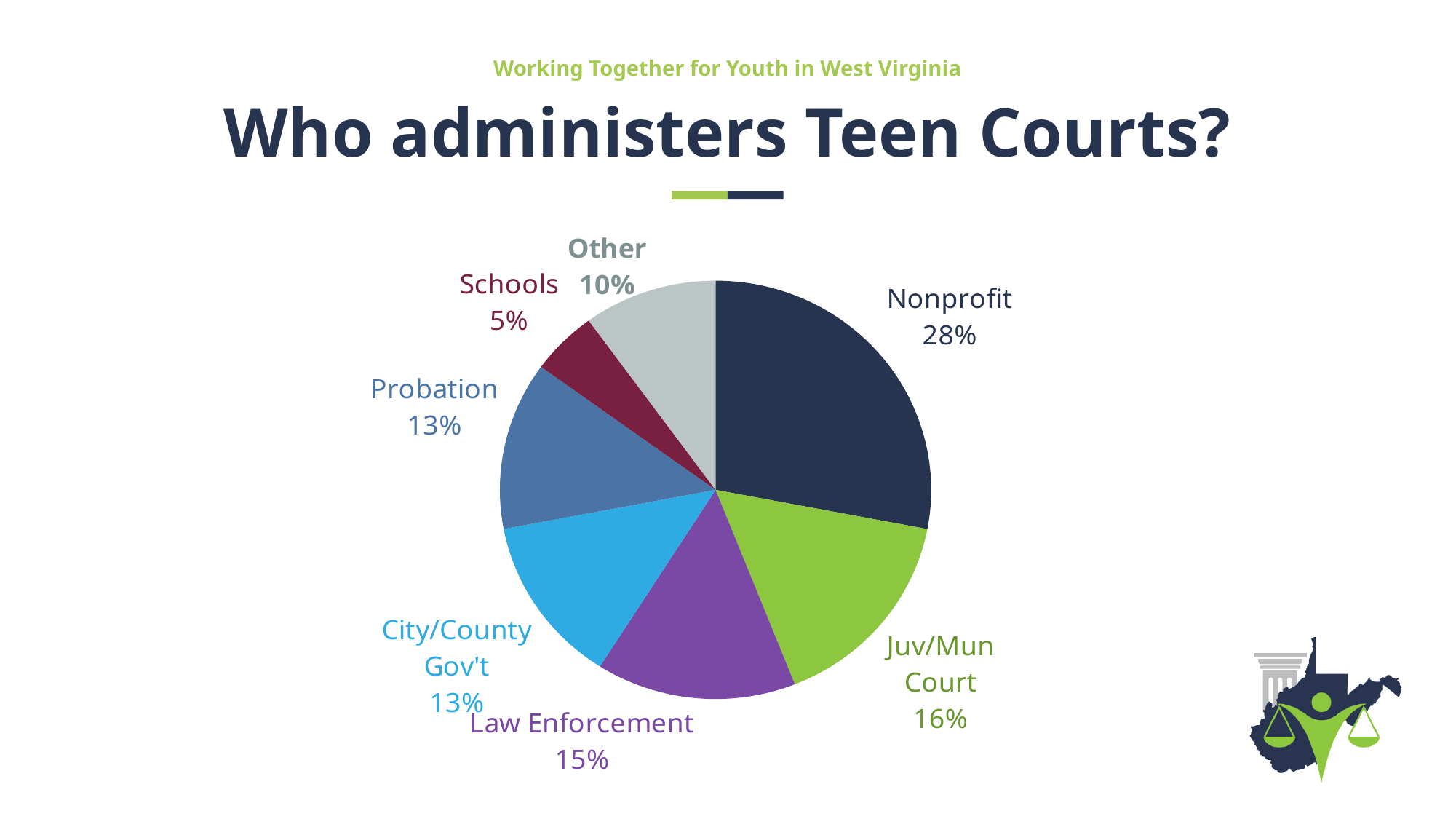
What kind of chart is shown on the slide? pie chart Which is larger, the share for Law Enforcement or the share for Probation? Law Enforcement Which category has the smallest slice of the pie? Schools What percentage is shown for Law Enforcement? 15% Which category has the largest slice of the pie? Nonprofit What share of Teen Courts is administered by Nonprofit organizations? 28% What is the difference in percentage points between Nonprofit and Juv/Mun Court? 12 What percentage is shown for Schools? 5% What is the difference in percentage points between Other and Schools? 5 What percentage is shown for Juv/Mun Court? 16% What is the title of the slide containing the chart? Who administers Teen Courts? How many categories are shown in the pie chart? 7